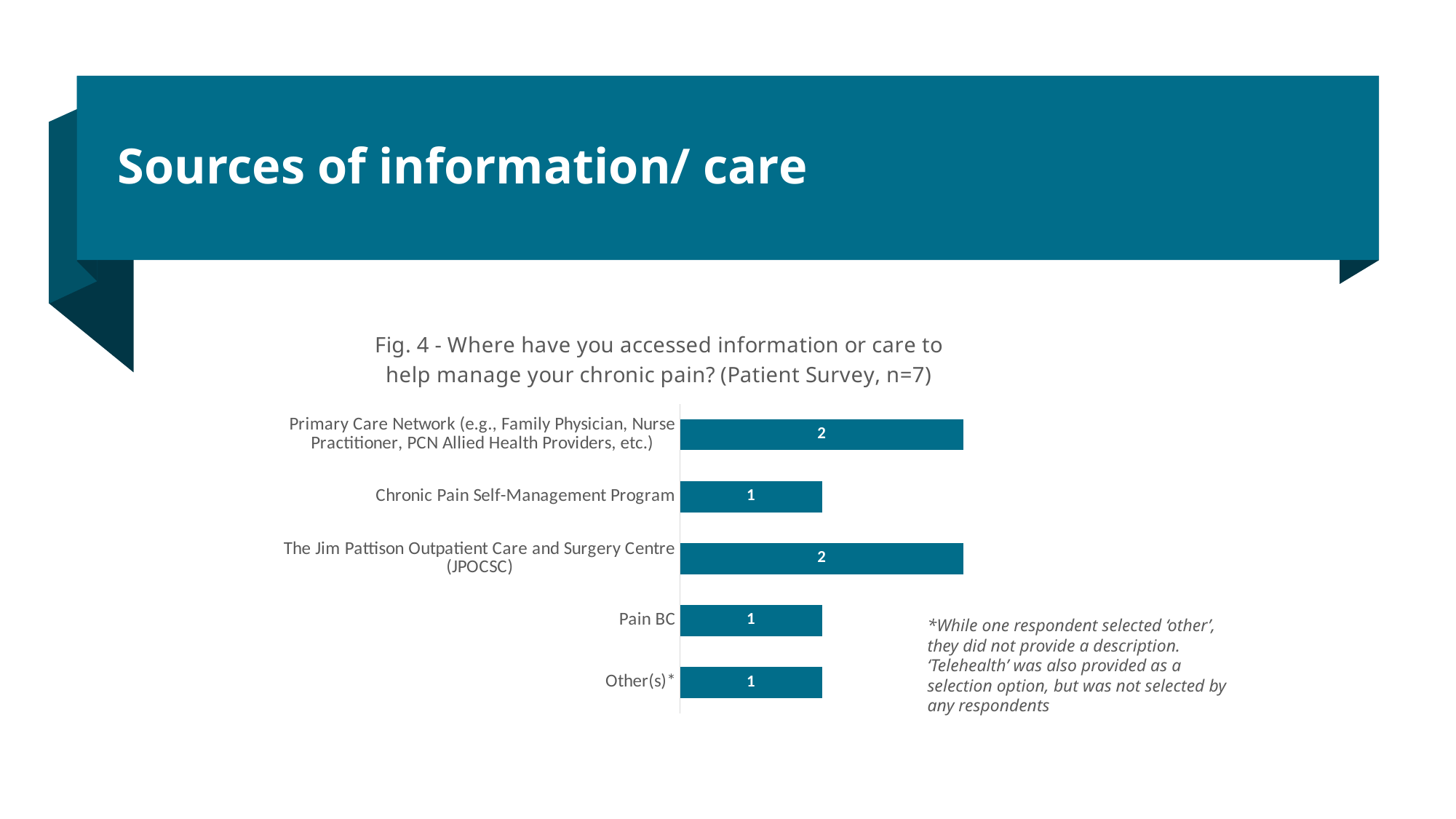
What value is shown for Other(s)*? 1 How many categories are shown in the chart? 5 What value is shown for Chronic Pain Self-Management Program? 1 What value is shown for Pain BC? 1 What kind of chart is shown on the slide? Bar chart How many categories have a value of 2? 2 What is the title of the chart? Fig. 4 - Where have you accessed information or care to help manage your chronic pain? (Patient Survey, n=7) What value is shown for The Jim Pattison Outpatient Care and Surgery Centre (JPOCSC)? 2 What is the total of all the values shown in the chart? 7 What is the difference between the value for Primary Care Network and the value for Pain BC? 1 Which is larger, the value for Chronic Pain Self-Management Program or the value for The Jim Pattison Outpatient Care and Surgery Centre (JPOCSC)? The Jim Pattison Outpatient Care and Surgery Centre (JPOCSC) What value is shown for Primary Care Network (e.g., Family Physician, Nurse Practitioner, PCN Allied Health Providers, etc.)? 2